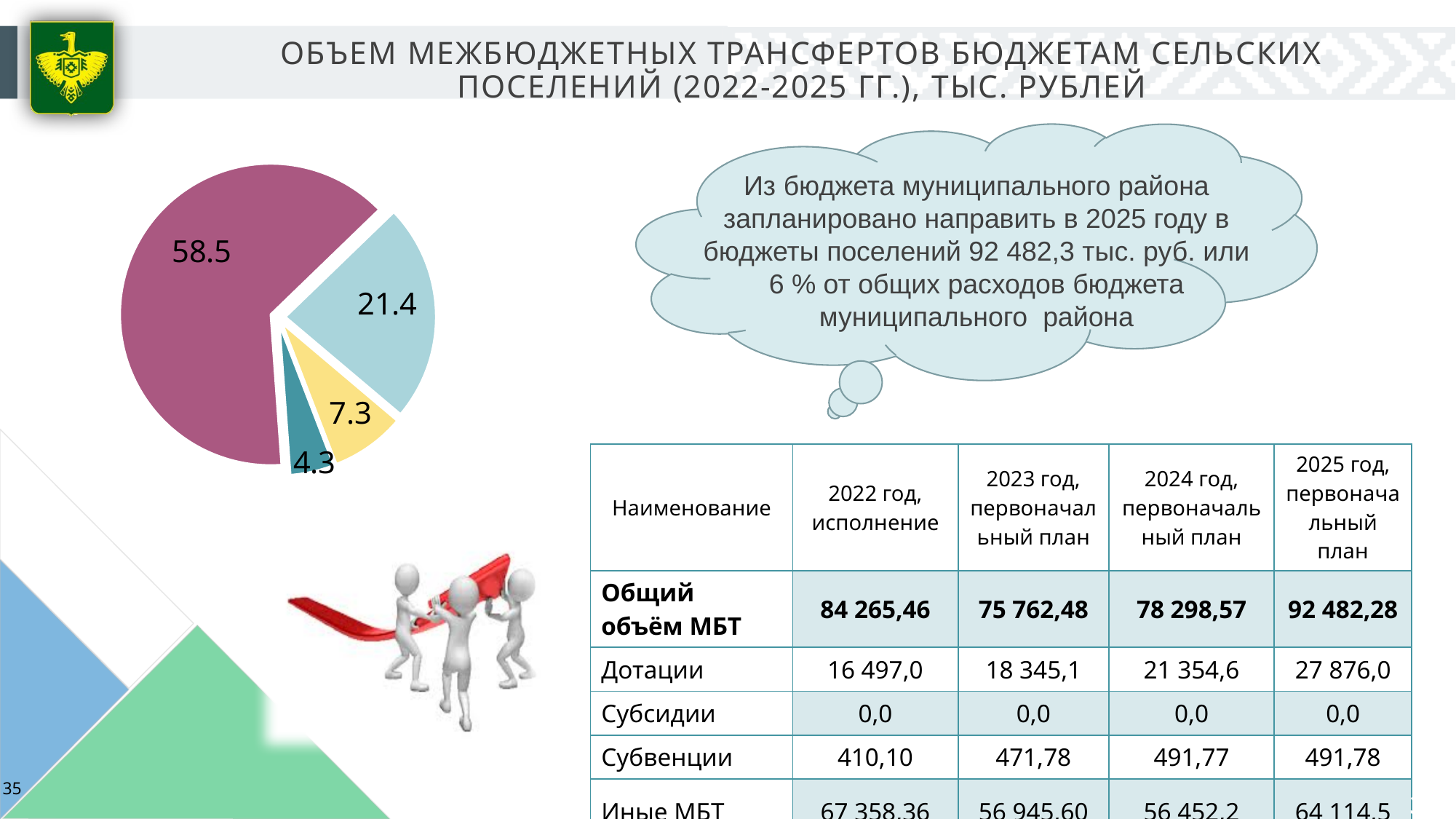
Which slice is larger in the pie chart, the light blue one or the yellow one? the light blue one What is the difference between the largest slice (58.5) and the second largest slice (21.4) in the pie chart? 37.1 What colour is the largest slice of the pie chart? magenta (purple-red) What is the value of the smallest slice in the pie chart? 4.3 How many slices does the pie chart have? 4 What is the value of the light blue slice in the pie chart? 21.4 What is the value of the yellow slice in the pie chart? 7.3 What kind of chart is shown on the left of the slide? pie chart Does the pie chart have a legend? No What is the value of the largest slice in the pie chart? 58.5 What is the difference between the yellow slice (7.3) and the dark teal slice (4.3) in the pie chart? 3.0 What is the value of the dark teal slice in the pie chart? 4.3